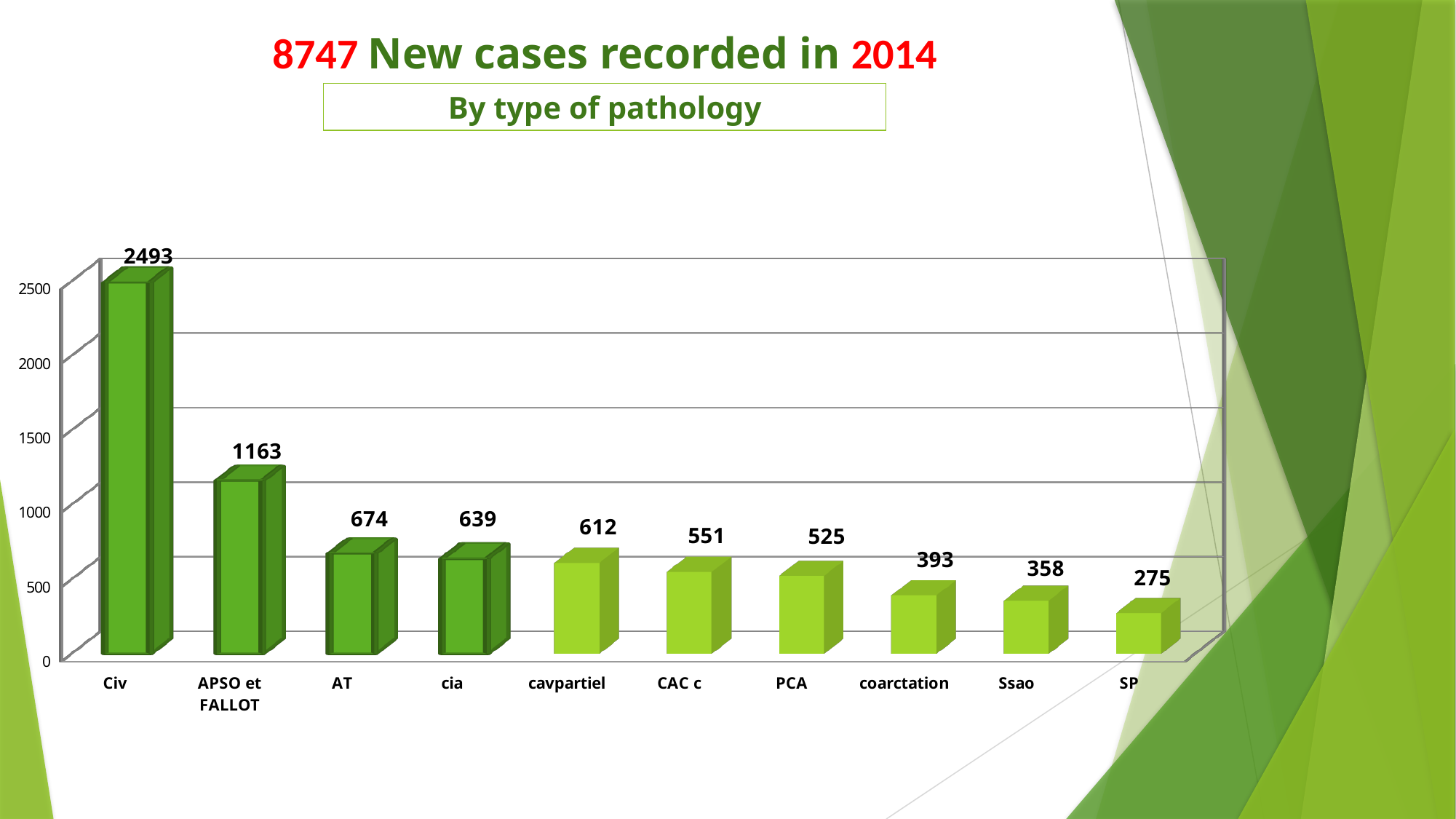
What kind of chart is shown on the slide? bar chart What is the subtitle shown in the box below the main title? By type of pathology Which category has the lowest value? SP What is the difference between the values for Civ and APSO et FALLOT? 1330 Which category has the highest value? Civ Which is larger, the value for AT or the value for cia? AT What is the value for Civ? 2493 Do the values rise or fall from left to right along the x axis? fall Is the value for PCA greater or less than 500? greater What is the value for coarctation? 393 How many categories are shown on the x axis? 10 What is the value for APSO et FALLOT? 1163